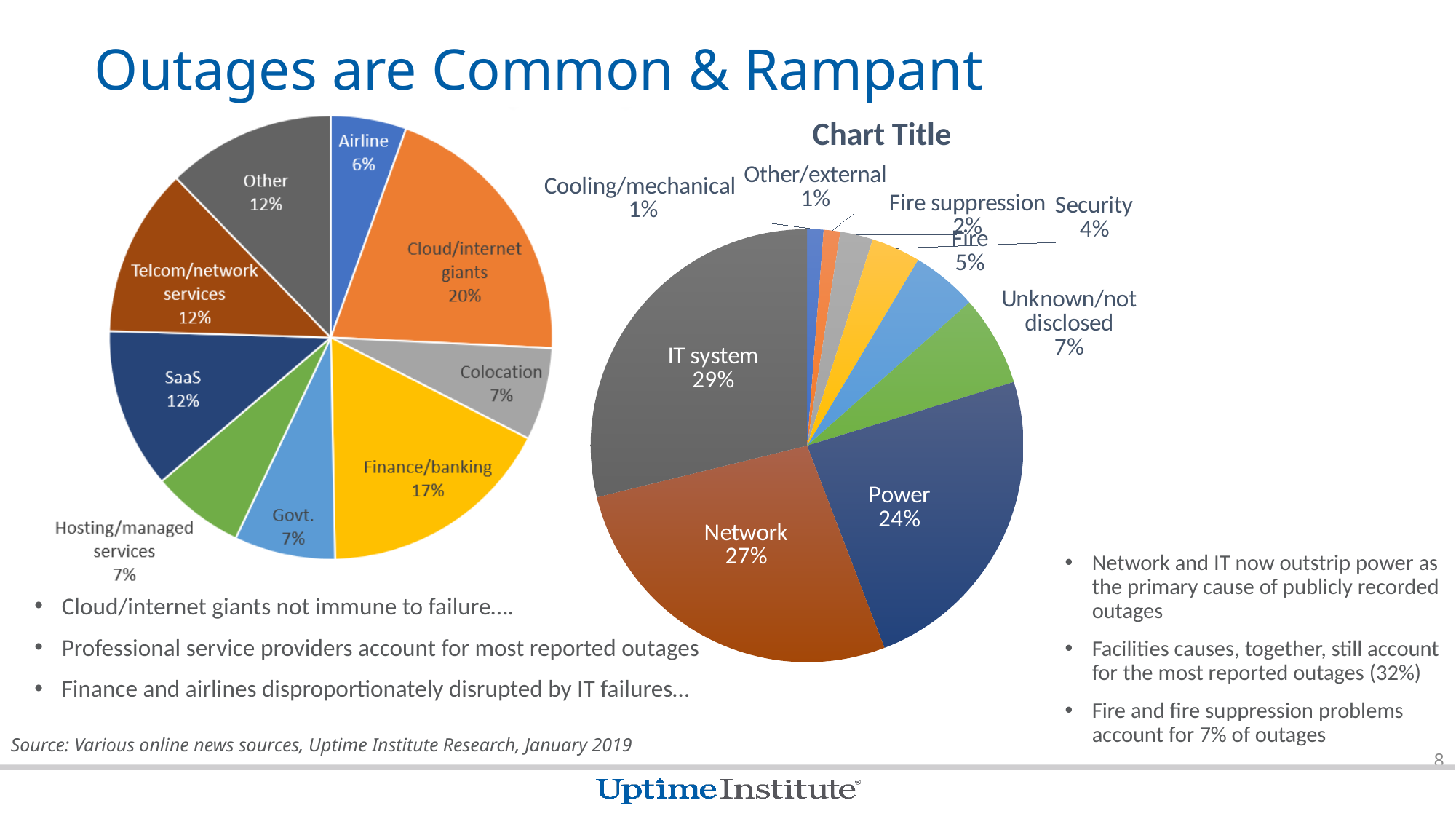
In the right pie chart, what is the difference between the Network share and the Power share? 3% In the left pie chart, what share do Cloud/internet giants account for? 20% In the left pie chart, which category has the smallest share? Airline In the right pie chart, which cause has the largest share? IT system In the right pie chart, which is larger: Fire or Security? Fire In the left pie chart, which is larger: SaaS or Colocation? SaaS How many categories does the right pie chart show? 9 In the left pie chart, which category has the largest share? Cloud/internet giants What type of chart is the right chart on the slide? Pie chart In the right pie chart, what share is attributed to Power? 24% How many categories does the left pie chart show? 9 In the left pie chart, what is the difference between the Finance/banking share and the Govt. share? 10%